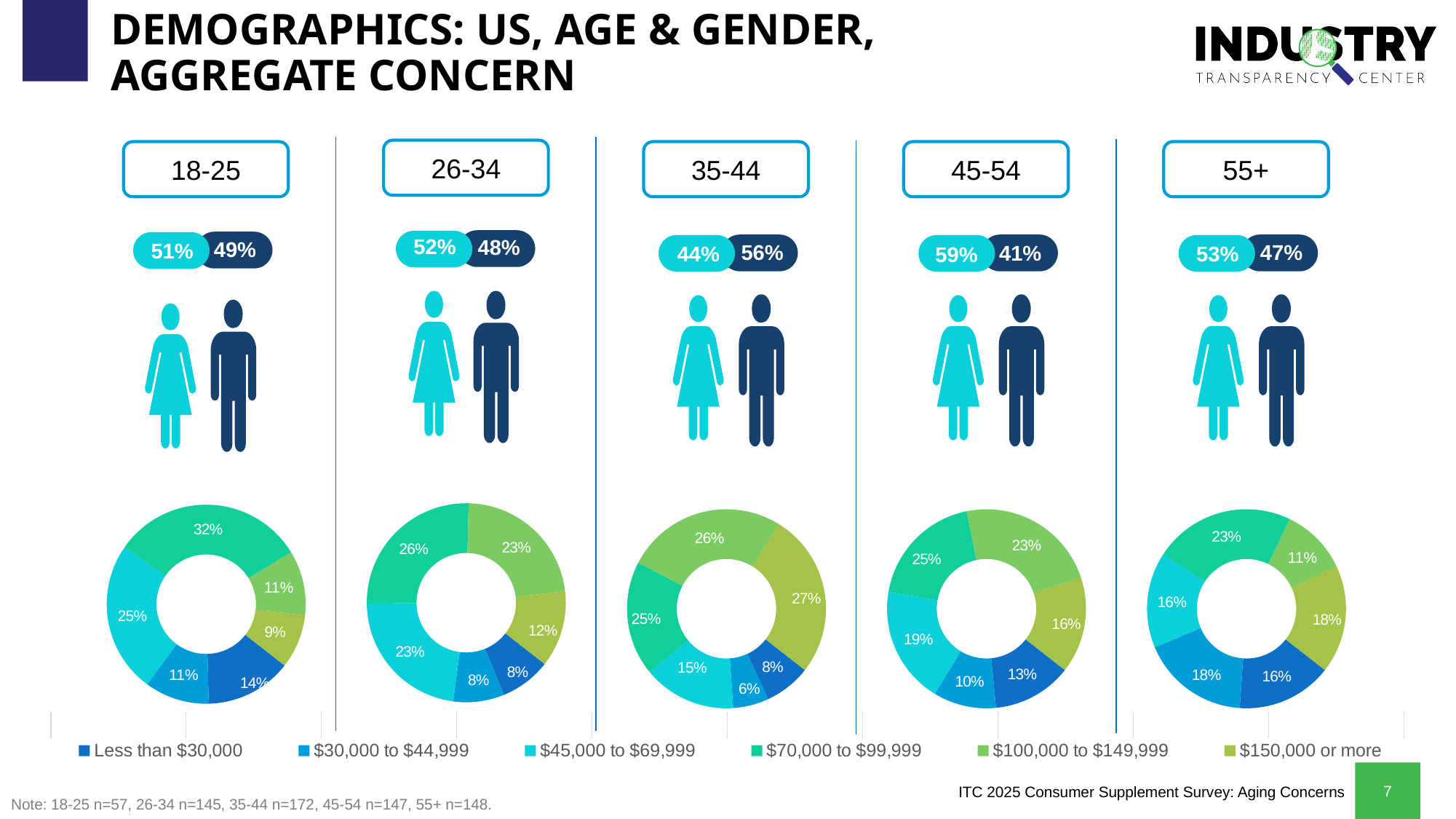
What percentage of the 35-44 age group is male (dark blue figure)? 56% What is the difference between the female and male shares in the 45-54 age group? 18% In the 35-44 donut chart, what is the share for $150,000 or more? 27% How many income brackets does the legend list? 6 How many donut charts are shown on the slide? 5 In the 18-25 donut chart, what is the largest slice's value? 32% What percentage of the 18-25 age group is female (cyan figure)? 51% In the 35-44 donut chart, what is the smallest slice's value? 6% Which age group has the highest female share? 45-54 What kind of chart is used to show the income distribution for each age group? Donut chart Which age group has the lowest female share? 35-44 In the 18-25 donut chart, which income bracket has the largest share? $70,000 to $99,999